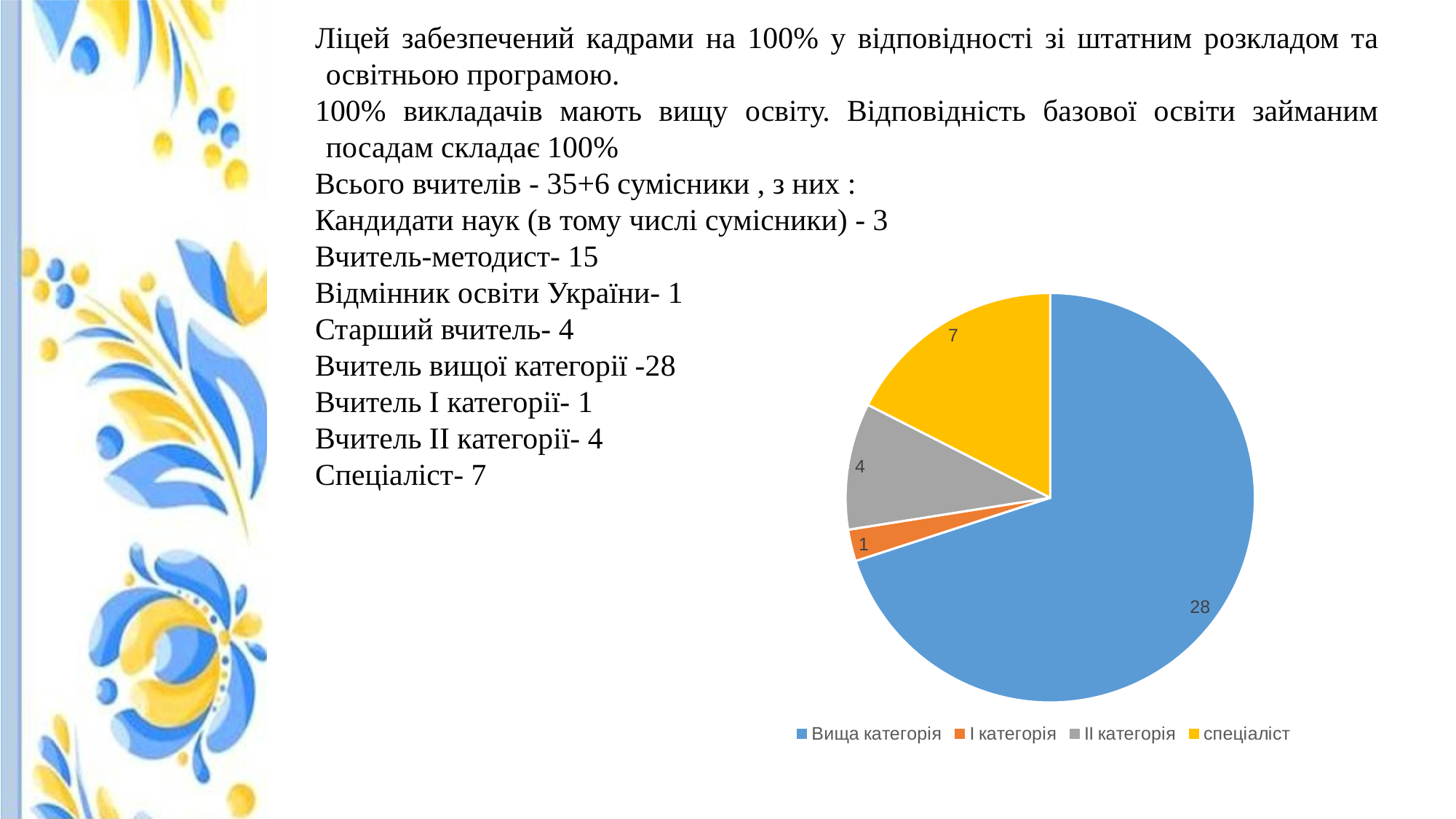
What is the difference between the values for Вища категорія and спеціаліст? 21 What type of chart is shown on the slide? pie chart Which is larger, the value for ІІ категорія or the value for спеціаліст? спеціаліст How many slices does the pie chart have? 4 What is the value for Вища категорія in the pie chart? 28 What colour is the slice for спеціаліст in the pie chart? yellow What is the value for І категорія in the pie chart? 1 What is the value for спеціаліст in the pie chart? 7 What share of the pie does Вища категорія represent? 70% What is the value for ІІ категорія in the pie chart? 4 Which category has the largest slice in the pie chart? Вища категорія Which category has the smallest slice in the pie chart? І категорія